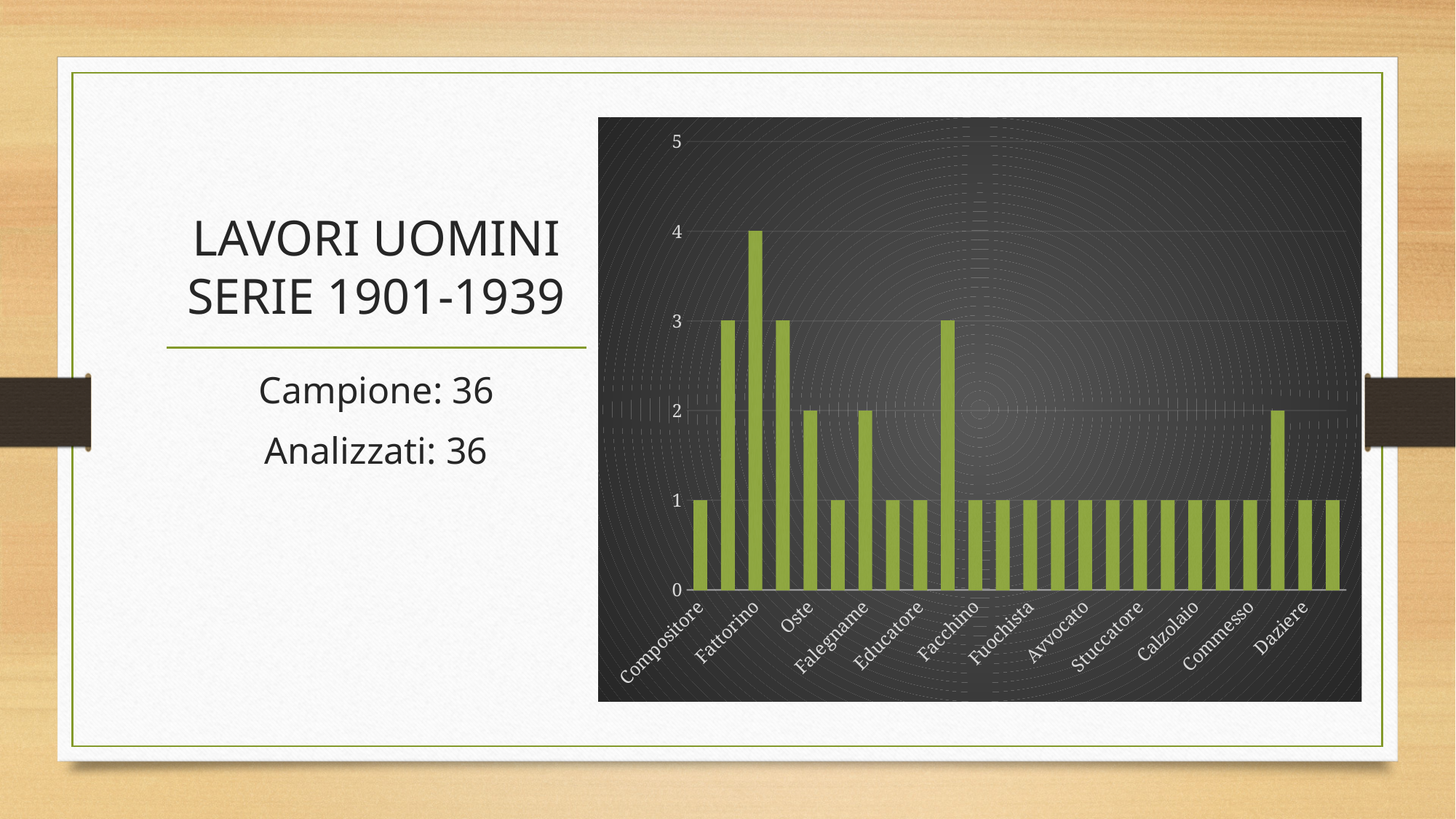
What is the value for Fattorino? 4 How many bars are plotted in the chart? 24 Which labelled category has the highest bar? Fattorino Which is larger, the value for Fattorino or the value for Oste? Fattorino What is the highest value shown on the vertical axis? 5 What is the value for Daziere? 1 What is the value for Compositore? 1 What is the value for Oste? 2 What is the value for Falegname? 2 Is the value for Fattorino greater or less than 3? greater What kind of chart is shown on the slide? Bar chart What is the difference between the value for Fattorino and the value for Educatore? 3